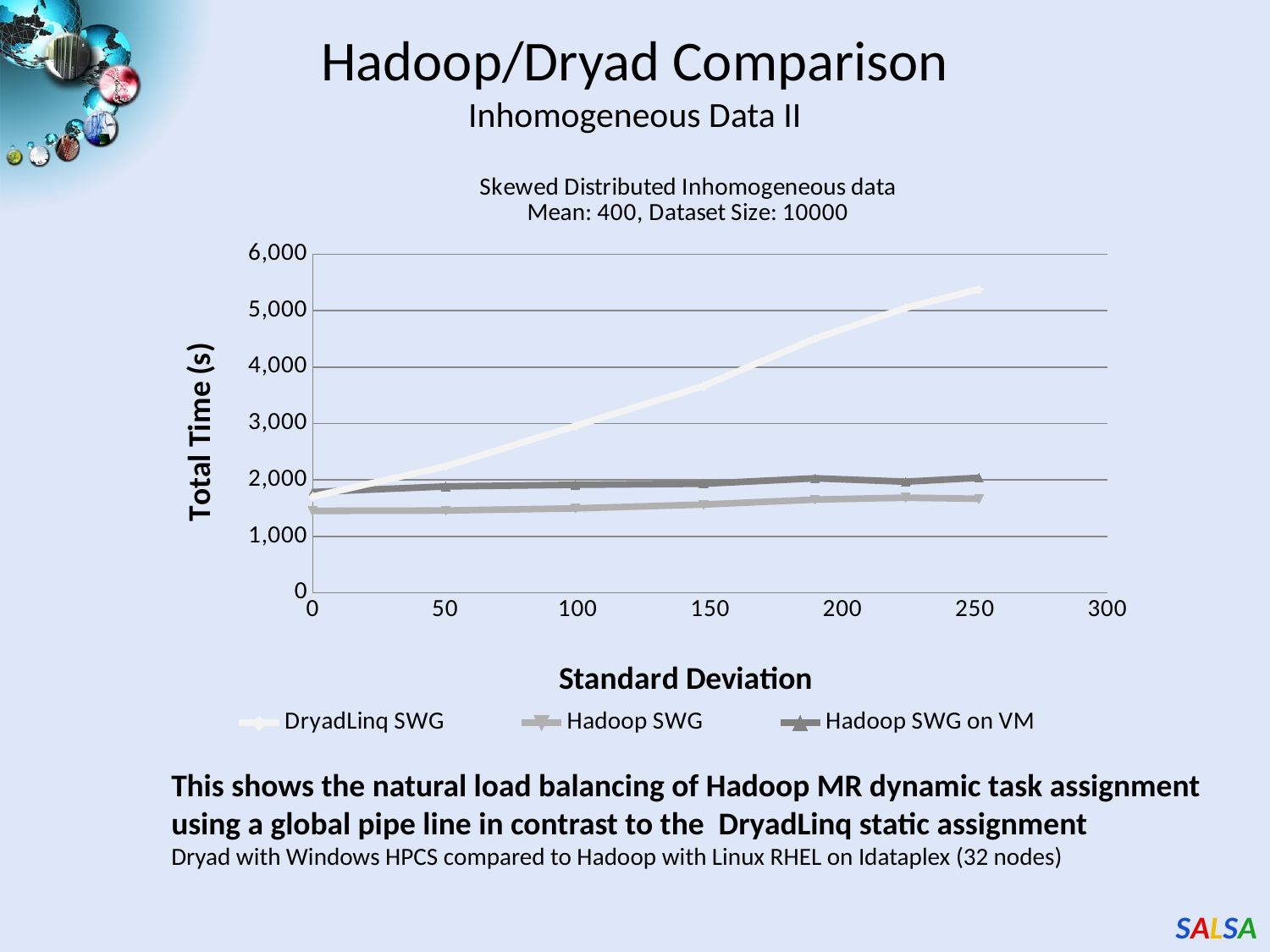
At a standard deviation of 200, which is larger: the total time for DryadLinq SWG or for Hadoop SWG on VM? DryadLinq SWG At a standard deviation of 250, which is larger: the total time for Hadoop SWG on VM or for Hadoop SWG? Hadoop SWG on VM Which series has the highest total time at a standard deviation of 250? DryadLinq SWG What is the label of the x axis? Standard Deviation Is the total time for Hadoop SWG at a standard deviation of 0 greater or less than 2,000? less Is the total time for DryadLinq SWG at a standard deviation of 250 greater or less than 5,000? greater What is the label of the y axis? Total Time (s) Which series has the lowest total time at a standard deviation of 250? Hadoop SWG Does the total time for DryadLinq SWG rise or fall as the standard deviation increases? rise What kind of chart is shown on the slide? line chart How many series does the legend list? 3 Is the total time for DryadLinq SWG at a standard deviation of 150 greater or less than 3,000? greater